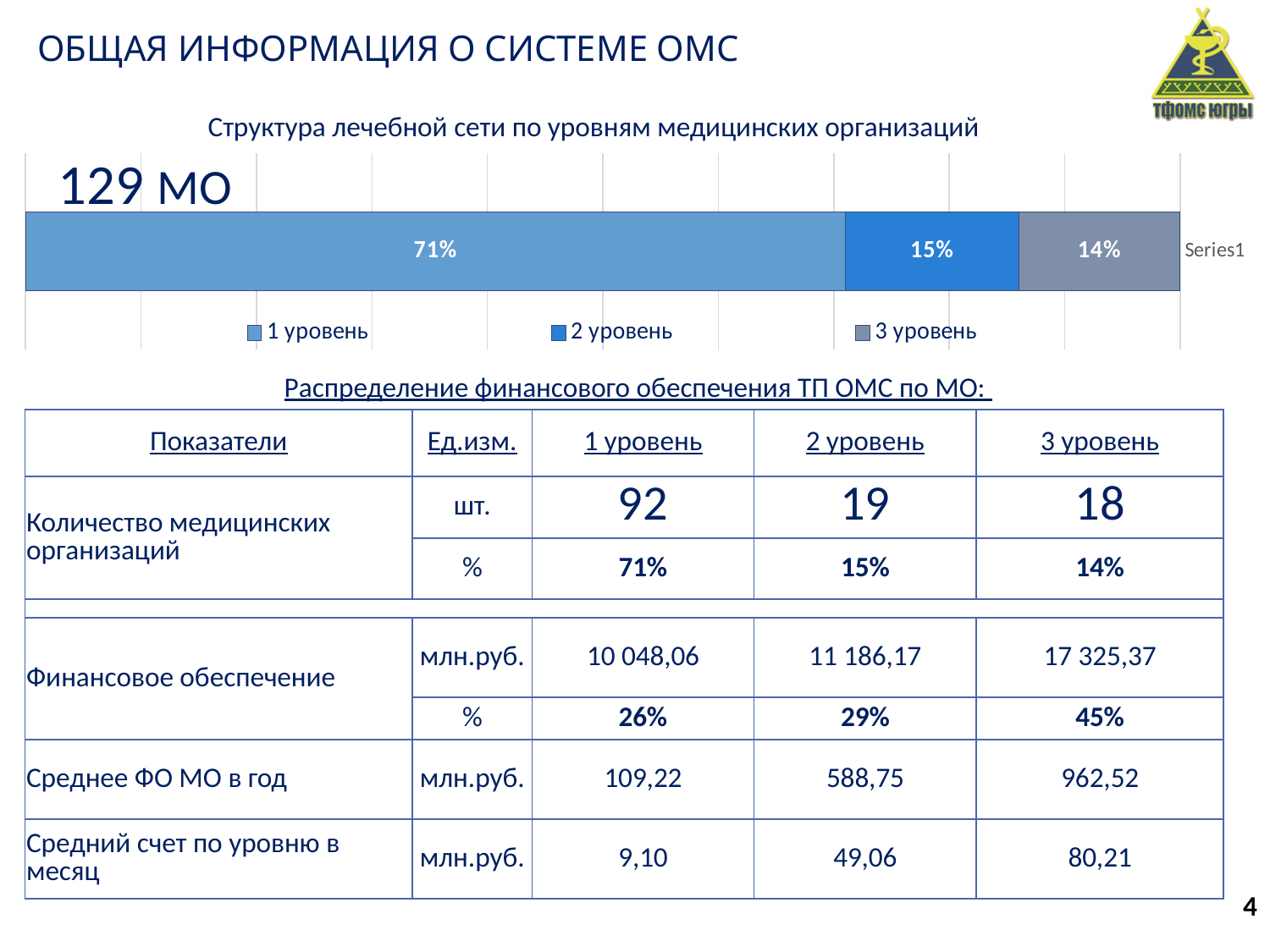
Which is larger in the chart, the value for 1 уровень or the value for 3 уровень? 1 уровень What is the value for 2 уровень in the chart? 15% Which level has the smallest share in the chart? 3 уровень What is the difference between the values for 2 уровень and 3 уровень in the chart? 1% What is the total of the stacked bar in the chart? 100% What is the title of the chart? Структура лечебной сети по уровням медицинских организаций What is the difference between the values for 1 уровень and 2 уровень in the chart? 56% What is the value for 1 уровень in the chart? 71% Which level has the largest share in the chart? 1 уровень What type of chart is shown on the slide? Stacked bar chart How many series does the chart legend list? 3 What is the value for 3 уровень in the chart? 14%